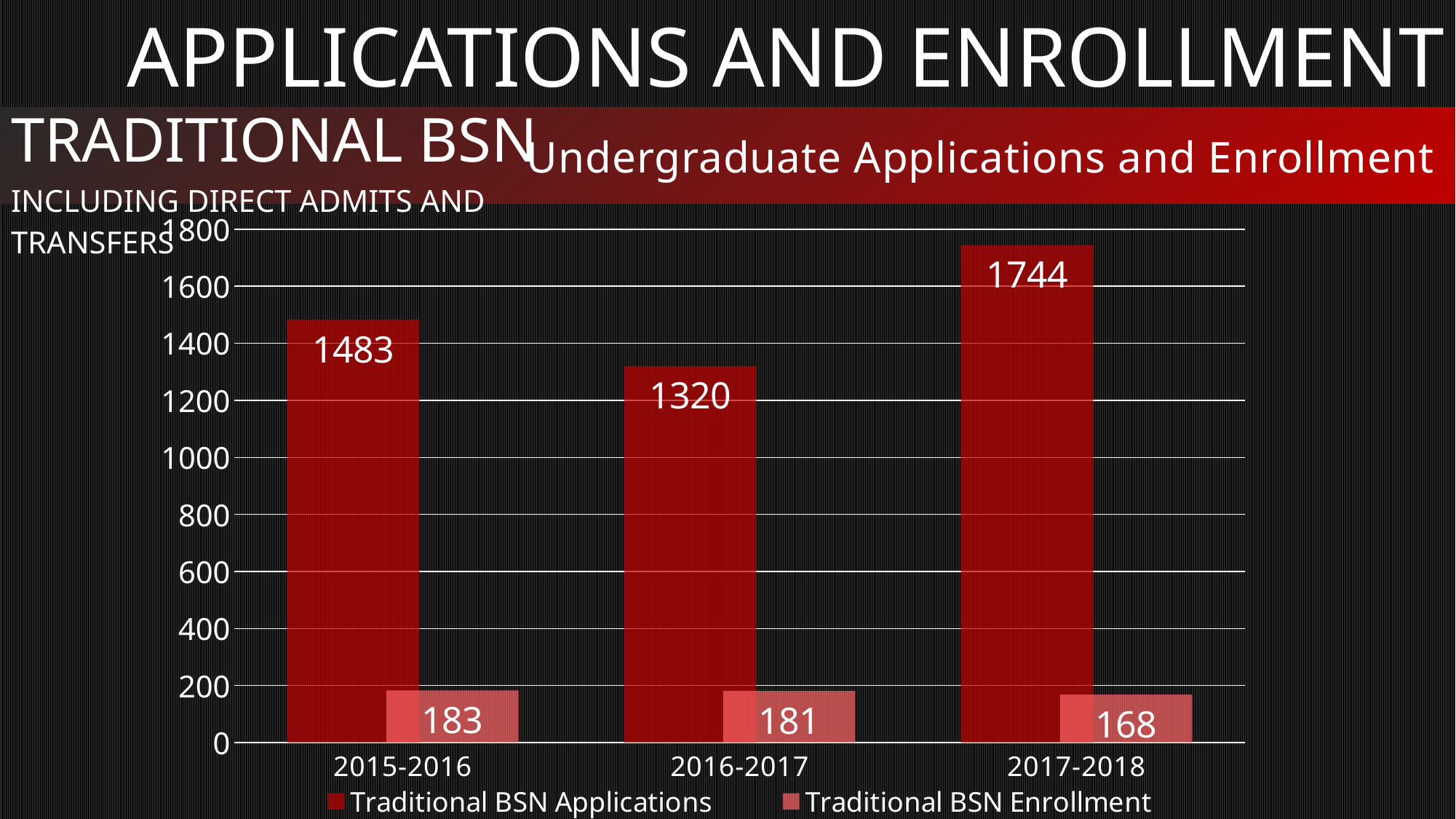
What kind of chart is shown on the slide? bar chart What is the value of Traditional BSN Enrollment for 2017-2018? 168 What is the difference between Traditional BSN Applications in 2017-2018 and 2016-2017? 424 Which year has the highest Traditional BSN Applications? 2017-2018 How many years are shown on the x axis? 3 Which is larger: Traditional BSN Enrollment in 2015-2016 or in 2017-2018? 2015-2016 Is the value for Traditional BSN Applications in 2016-2017 greater or less than 1400? less What is the value of Traditional BSN Applications for 2015-2016? 1483 What is the value of Traditional BSN Applications for 2016-2017? 1320 What is the title of the chart? Undergraduate Applications and Enrollment Which year has the lowest Traditional BSN Enrollment? 2017-2018 How many series does the legend list? 2